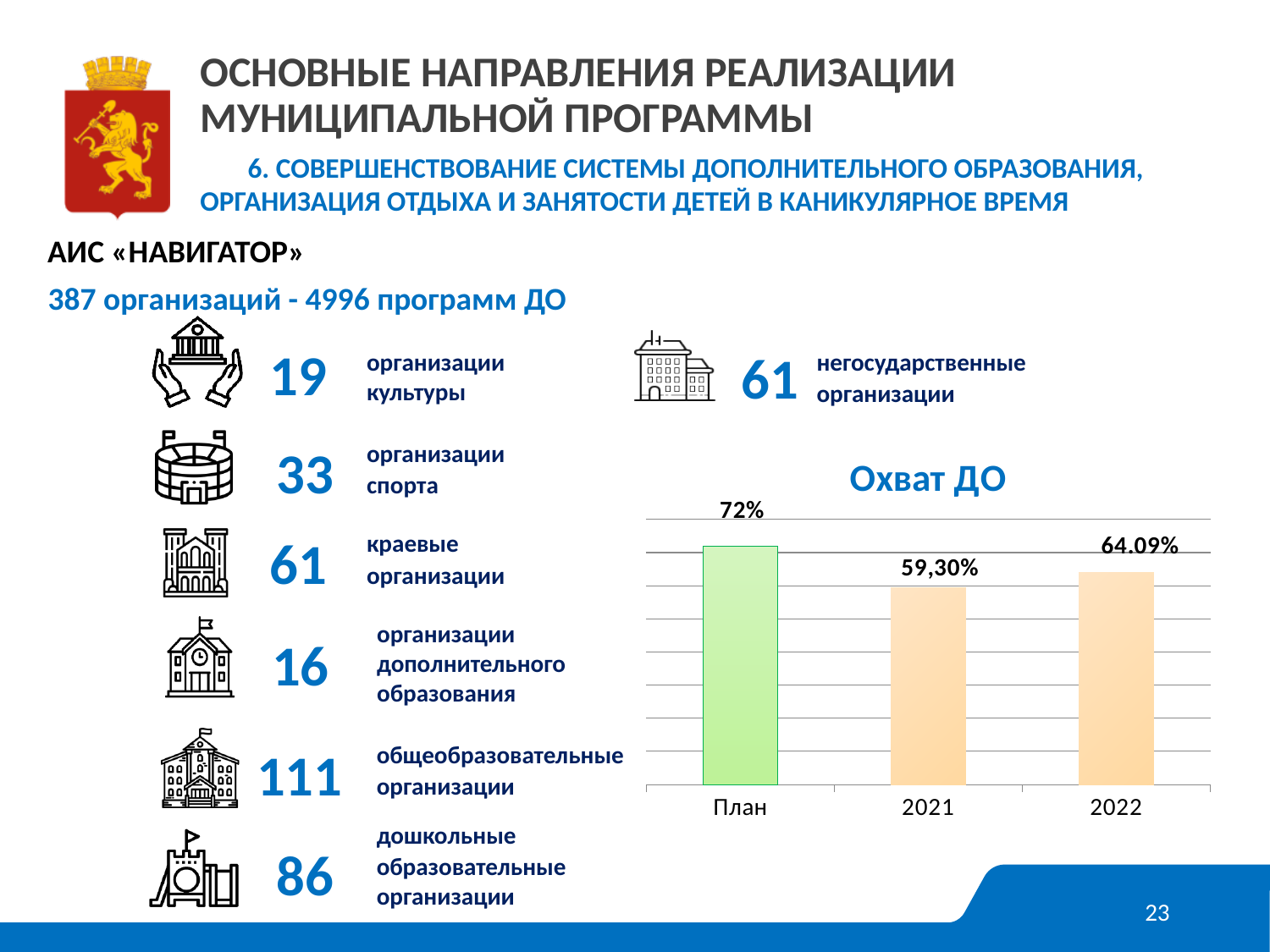
What is the value for 2022 in the Охват ДО chart? 64.09% Which category has the highest value in the Охват ДО chart? План Which is larger in the Охват ДО chart, the value for План or the value for 2022? План Does the value rise or fall from 2021 to 2022 in the Охват ДО chart? rise Which is larger in the Охват ДО chart, the value for 2021 or the value for 2022? 2022 What is the value for План in the Охват ДО chart? 72% What is the title of the chart on the slide? Охват ДО What is the value for 2021 in the Охват ДО chart? 59,30% Which bar in the Охват ДО chart is coloured green? План Which category has the lowest value in the Охват ДО chart? 2021 How many bars are shown in the Охват ДО chart? 3 What kind of chart is the Охват ДО chart? bar chart